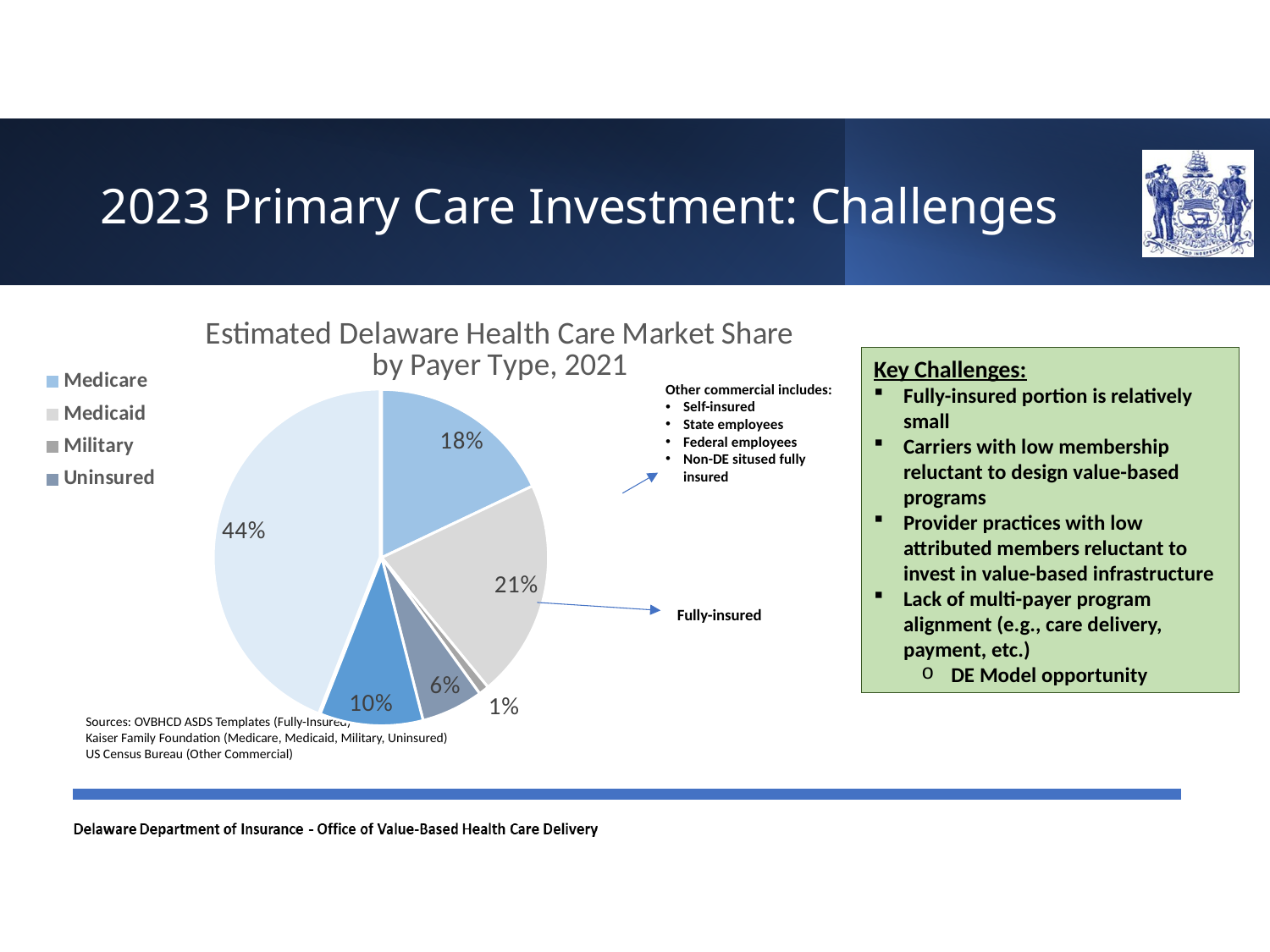
What is the sum of the Fully-insured and Other commercial shares? 54% How many entries are visible in the chart's legend? 4 Which legend entry is listed first in the chart's legend? Medicare What kind of chart is shown on the slide? pie chart What share of the pie is labelled as Fully-insured? 10% How many slices does the pie chart have? 6 What share of the pie is labelled as Other commercial? 44% What is the largest percentage shown on the pie chart? 44% What is the difference between the Other commercial share and the Fully-insured share? 34% What is the title of the chart? Estimated Delaware Health Care Market Share by Payer Type, 2021 What is the smallest percentage shown on the pie chart? 1% Which is larger, the Other commercial slice or the Fully-insured slice? Other commercial